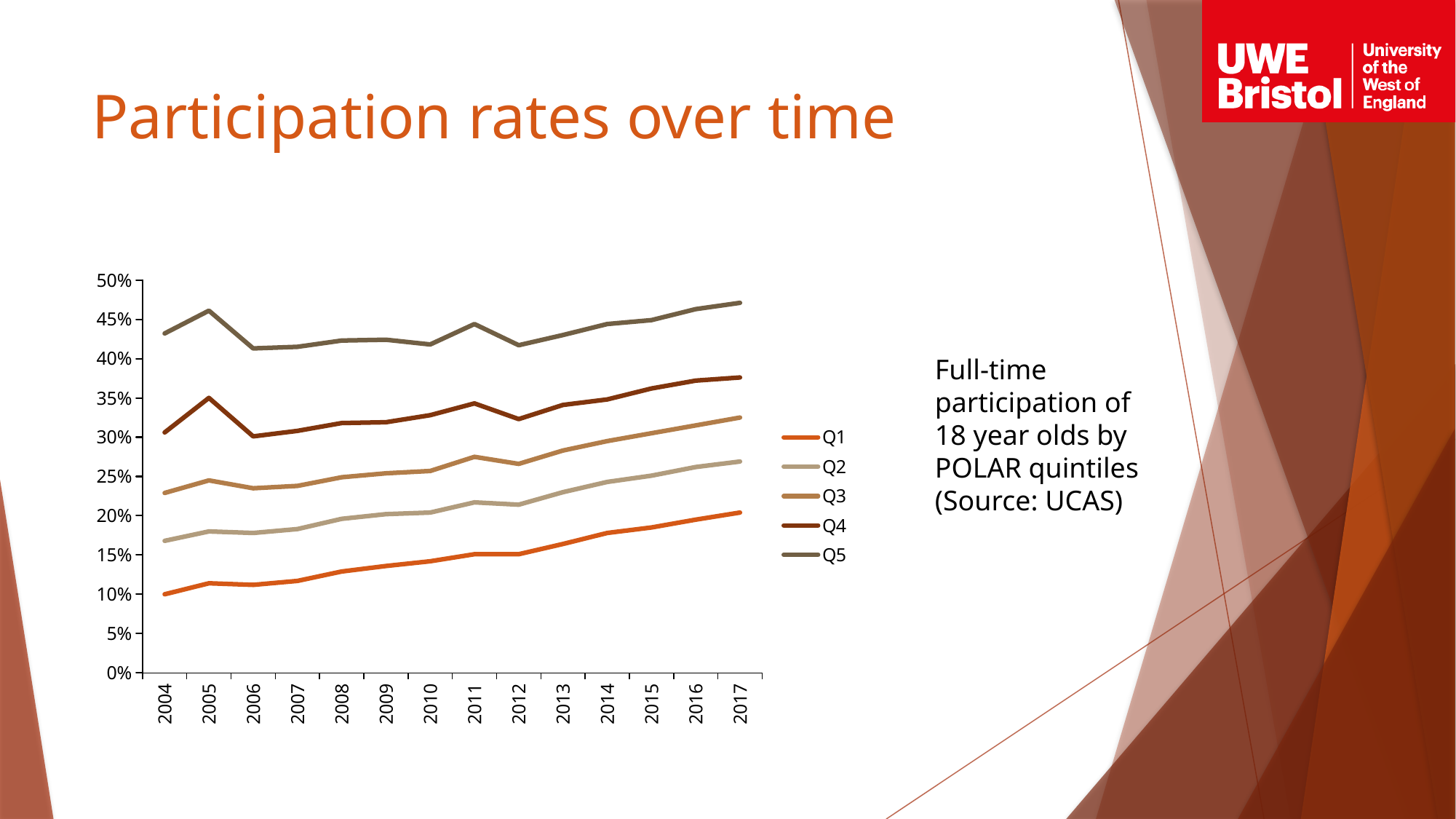
How many years are shown on the x axis? 14 Is the value for Q4 in 2017 greater or less than 35%? greater Does the Q1 participation rate generally rise or fall from 2004 to 2017? rise How many series does the legend list? 5 What kind of chart is shown on the slide? line chart Which series has the highest participation rate across all years? Q5 Which series has the lowest participation rate across all years? Q1 Which is larger for Q5: the value in 2005 or the value in 2006? 2005 Is the value for Q1 in 2014 greater or less than 15%? greater Is the value for Q2 in 2004 greater or less than 20%? less In which year is the Q1 participation rate lowest? 2004